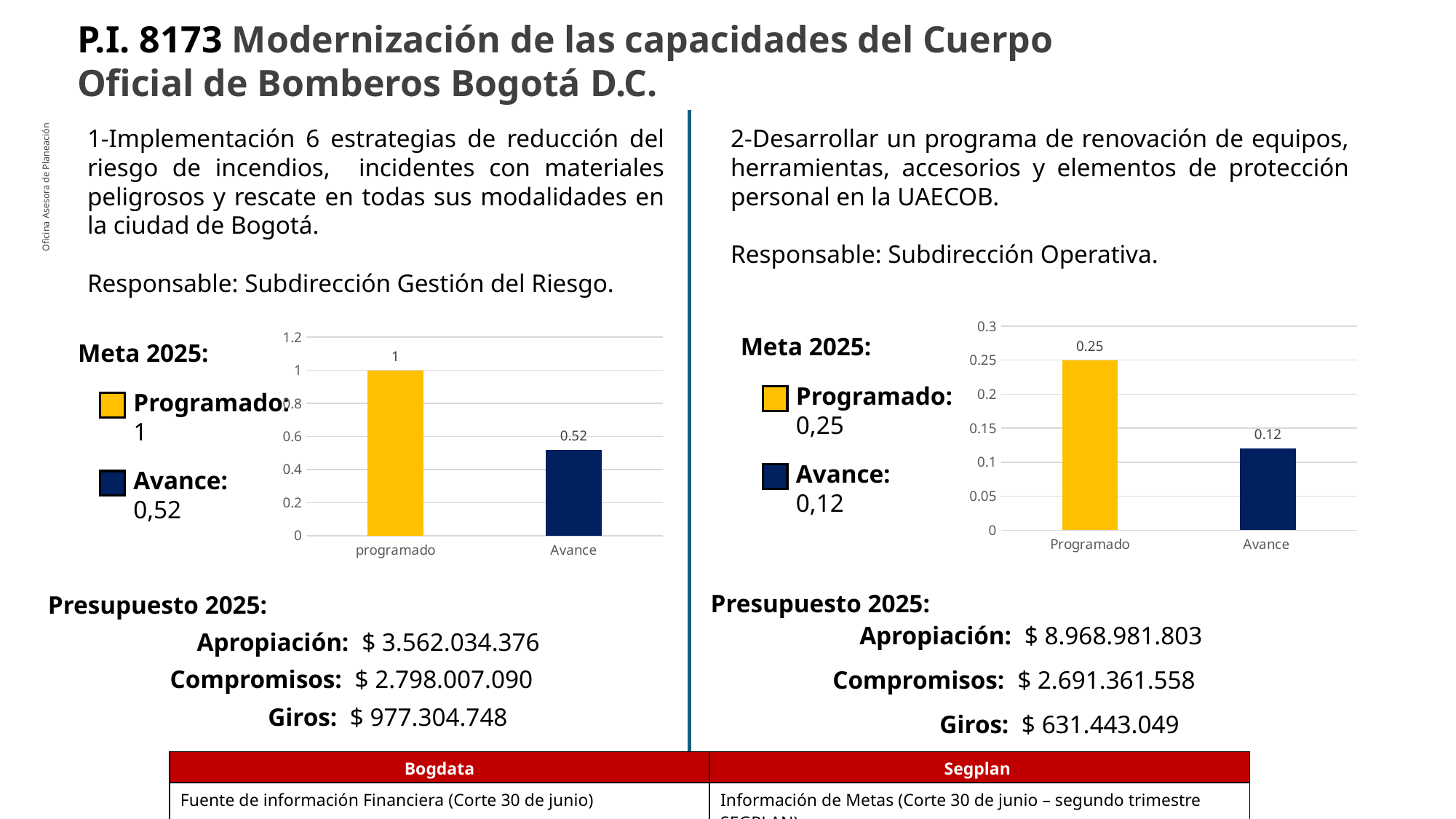
In the right chart, what is the difference between the Programado and Avance values? 0.13 In the right chart, what is the value for Avance? 0.12 In the right chart, which category has the lowest value? Avance In the left chart, what is the value for programado? 1 In the left chart, what is the value for Avance? 0.52 What kind of chart is the right chart? Bar chart How many bars are plotted in the left chart? 2 In the right chart, what is the value for Programado? 0.25 In the left chart, what colour is the Avance bar? Dark blue In the left chart, what is the difference between the programado and Avance values? 0.48 In the left chart, which category has the highest value? programado In the right chart, which is larger, Programado or Avance? Programado